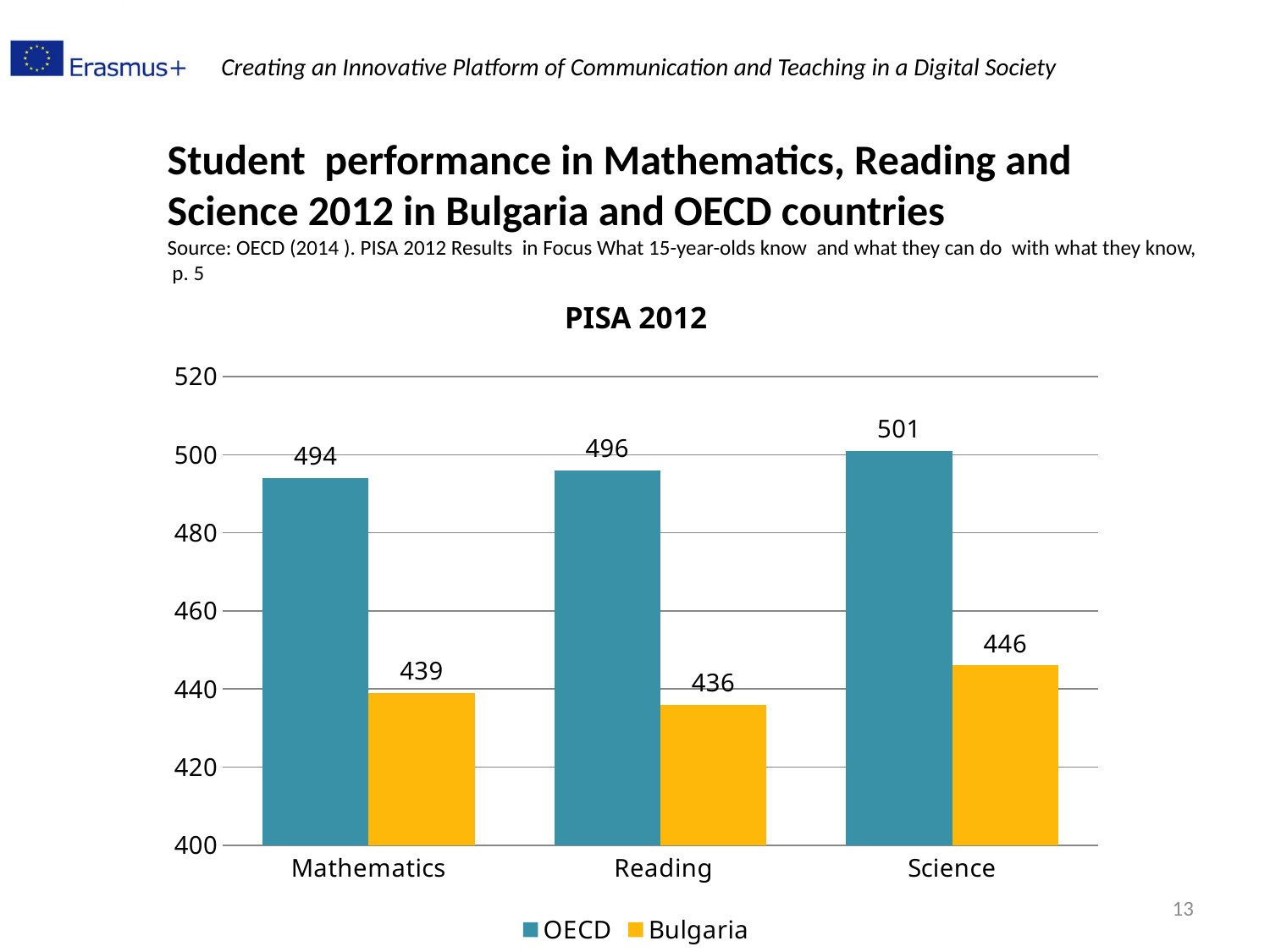
What is the difference between the OECD and Bulgaria values for Science? 55 How many subject categories are shown on the x axis? 3 What kind of chart is shown on the slide? Bar chart In which subject does Bulgaria have its highest score? Science What is the Bulgaria value for Science? 446 What is the OECD value for Mathematics? 494 What is the OECD value for Science? 501 What is the Bulgaria value for Reading? 436 How many series does the legend list? 2 Which is larger, the OECD value for Reading or the OECD value for Science? Science What is the difference between the OECD and Bulgaria values for Mathematics? 55 In which subject does Bulgaria have its lowest score? Reading